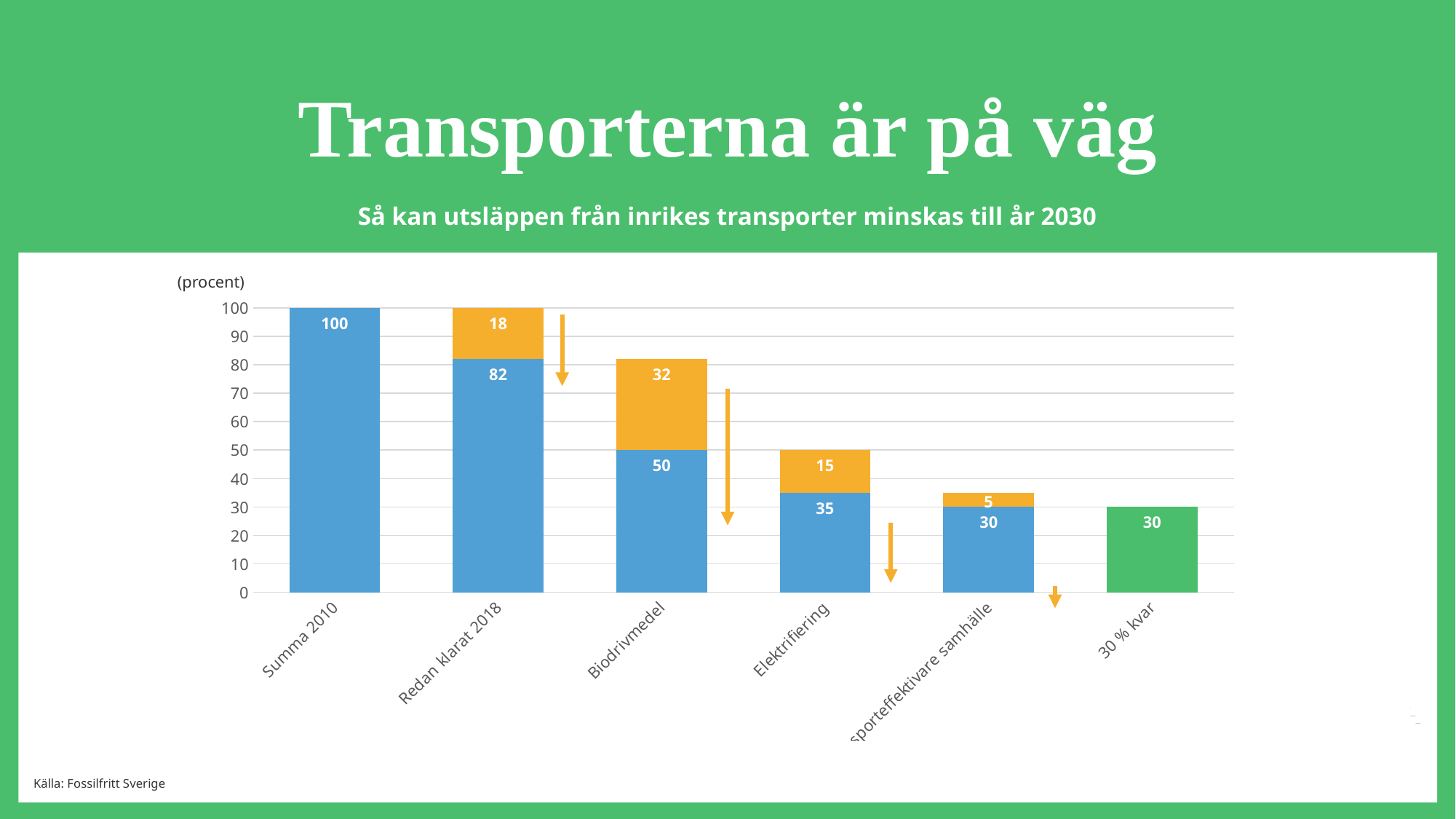
What is the value shown for Summa 2010? 100 What is the total of the stacked bar for Redan klarat 2018? 100 Which category has the largest orange segment? Biodrivmedel What unit is indicated on the vertical axis of the chart? (procent) Which is larger: the orange segment for Elektrifiering or the orange segment for Redan klarat 2018? Redan klarat 2018 What is the difference between the orange segment for Biodrivmedel and the orange segment for Redan klarat 2018? 14 What is the total of the stacked bar for Biodrivmedel? 82 What is the value of the blue segment for Elektrifiering? 35 What is the value of the orange segment for Biodrivmedel? 32 How many bars are shown in the chart? 6 What is the value shown for 30 % kvar? 30 Which category has the smallest orange segment? The fifth bar from the left (…sporteffektivare samhälle)